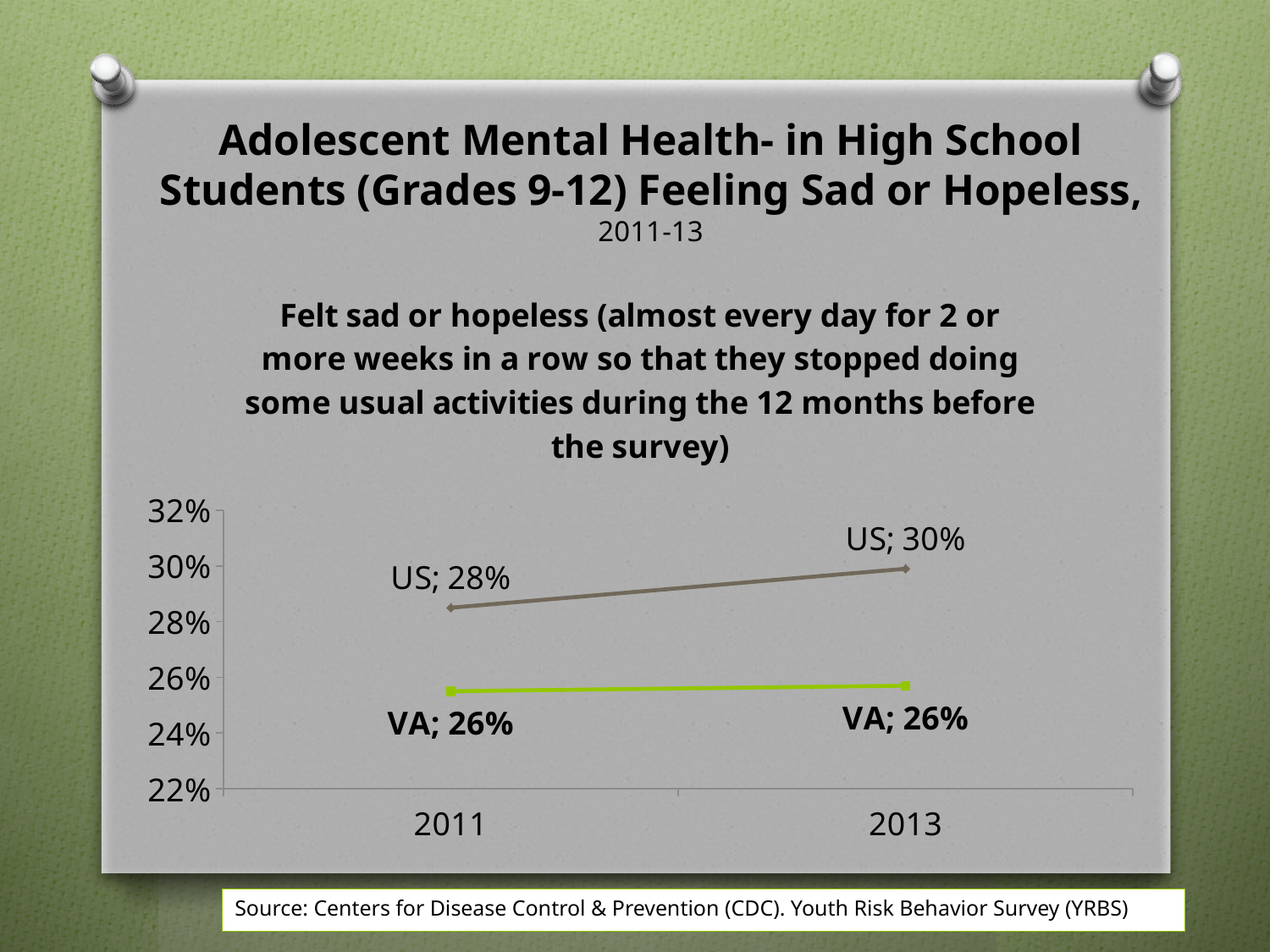
What is the source cited below the chart? Centers for Disease Control & Prevention (CDC). Youth Risk Behavior Survey (YRBS) What is the VA value in 2011? 26% What is the VA value in 2013? 26% How many data series are plotted on the chart? 2 What is the US value in 2013? 30% What is the US value in 2011? 28% What kind of chart is shown on the slide? line chart By how many percentage points did the US value change from 2011 to 2013? 2 percentage points How many years are plotted on the x axis? 2 Which series has the higher value in 2011, US or VA? US Does the US line rise or fall from 2011 to 2013? rise What is the difference between the US and VA values in 2013? 4 percentage points